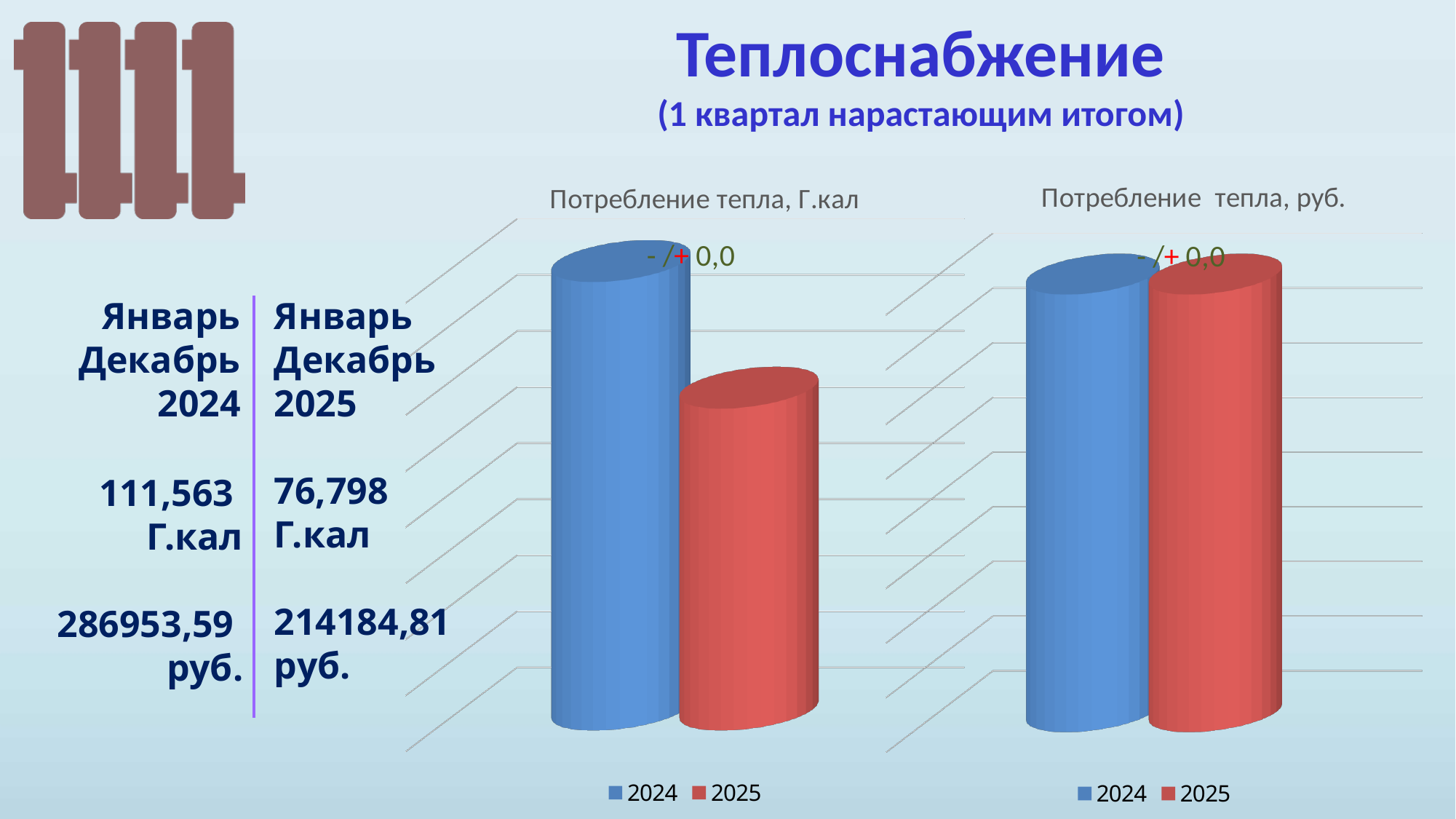
In the "Потребление тепла, Г.кал" chart, which series has the taller bar, 2024 or 2025? 2024 According to the slide, what is the heat consumption in Г.кал for January–December 2025? 76,798 Г.кал What kind of chart is the "Потребление тепла, Г.кал" chart? bar chart According to the slide, what is the heat consumption in rubles for January–December 2024? 286953,59 руб. How many series does the legend of the "Потребление тепла, Г.кал" chart list? 2 In the "Потребление тепла, Г.кал" chart, do the values rise or fall from 2024 to 2025? fall How many bars are plotted in the "Потребление тепла, руб." chart? 2 What is the title of the right-hand chart? Потребление тепла, руб. In the "Потребление тепла, Г.кал" chart, which colour represents the 2025 series? red In the "Потребление тепла, Г.кал" chart, which series has the lowest bar? 2025 According to the slide, what is the heat consumption in rubles for January–December 2025? 214184,81 руб. According to the slide, what is the heat consumption in Г.кал for January–December 2024? 111,563 Г.кал